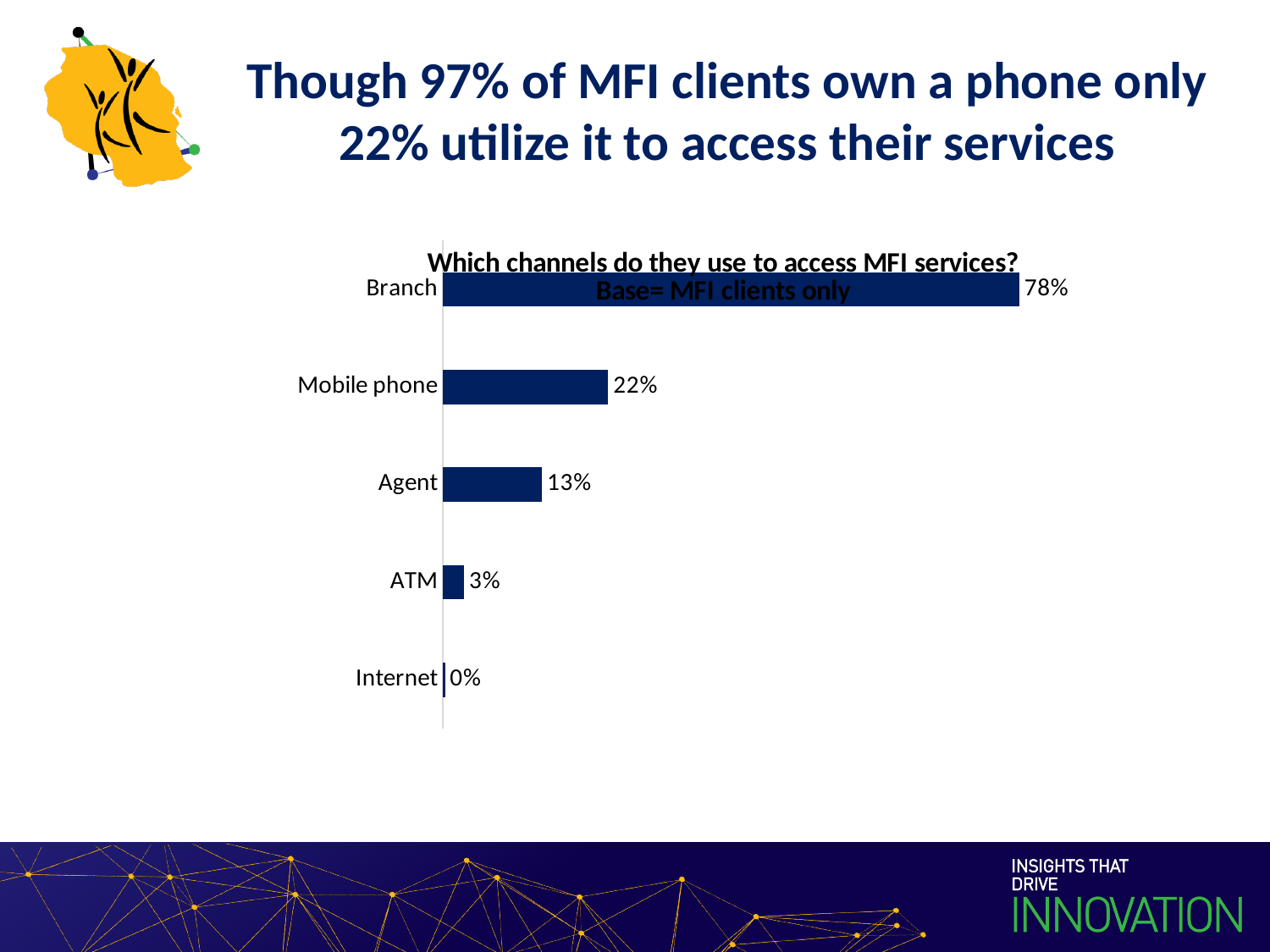
How many channels are shown in the chart? 5 Which channel has the highest value? Branch What type of chart is shown on the slide? Bar chart What is the value shown for Mobile phone? 22% What base is stated for the chart? MFI clients only What is the value shown for Agent? 13% Which channel has the lowest value? Internet What is the difference between the Branch and Mobile phone values? 56% Which is larger, the value for Agent or the value for ATM? Agent What percentage of MFI clients use a branch to access MFI services? 78% What is the value shown for ATM? 3% What is the title of the chart? Which channels do they use to access MFI services?